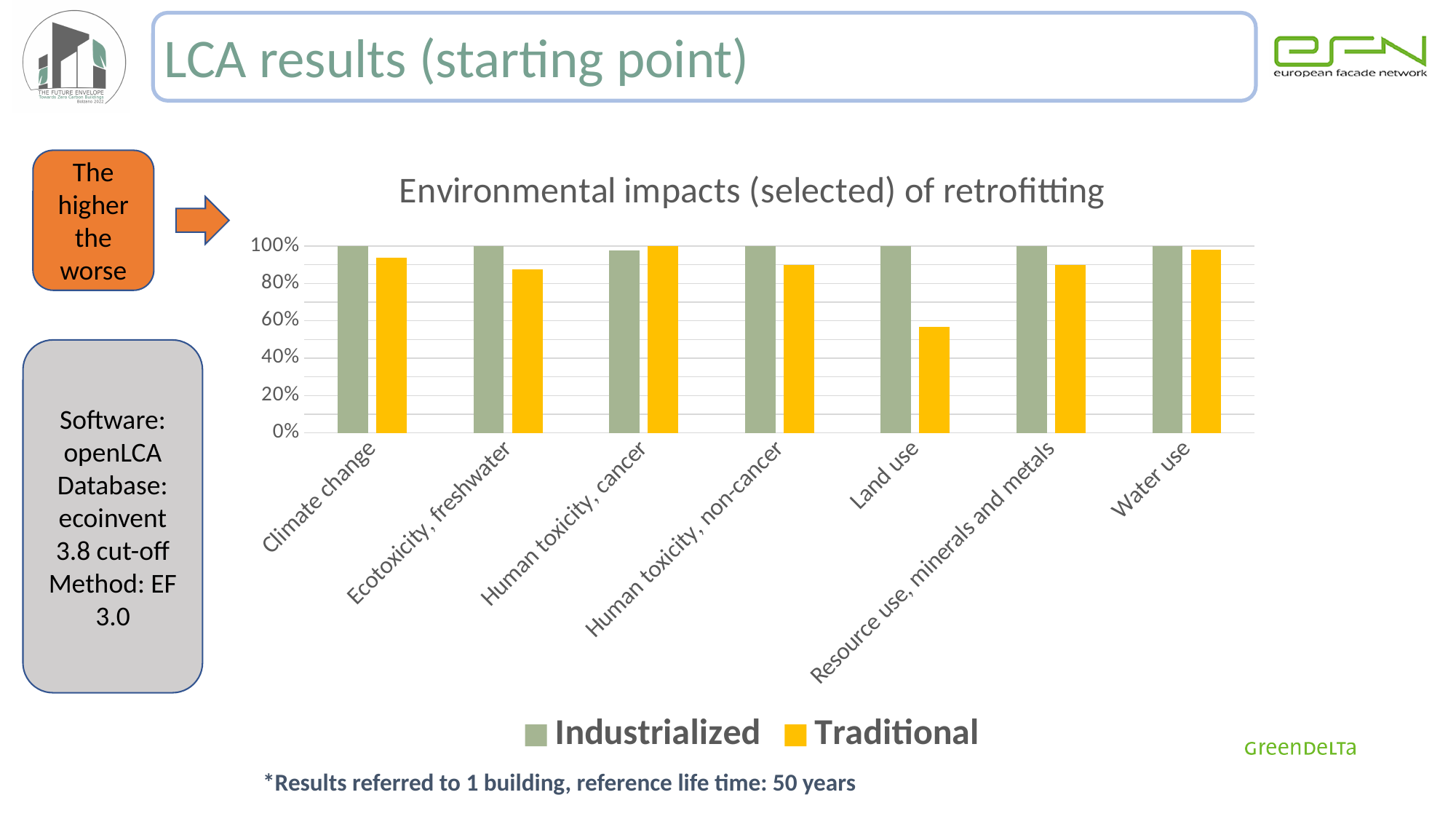
How many impact categories are shown on the x axis of the chart? 7 Which colour represents the Traditional series in the chart? Yellow Is the Traditional value for Ecotoxicity, freshwater greater or less than 80%? greater How many series does the chart legend list? 2 What is the title of the chart? Environmental impacts (selected) of retrofitting Which category has the lowest Traditional value? Land use What is the value of the Traditional bar for Human toxicity, cancer? 100% For Land use, which series has the larger value, Industrialized or Traditional? Industrialized For Human toxicity, cancer, which series has the larger value, Industrialized or Traditional? Traditional What is the value of the Industrialized bar for Climate change? 100% Is the Traditional value for Land use greater or less than 60%? less What type of chart is shown on the slide? Bar chart